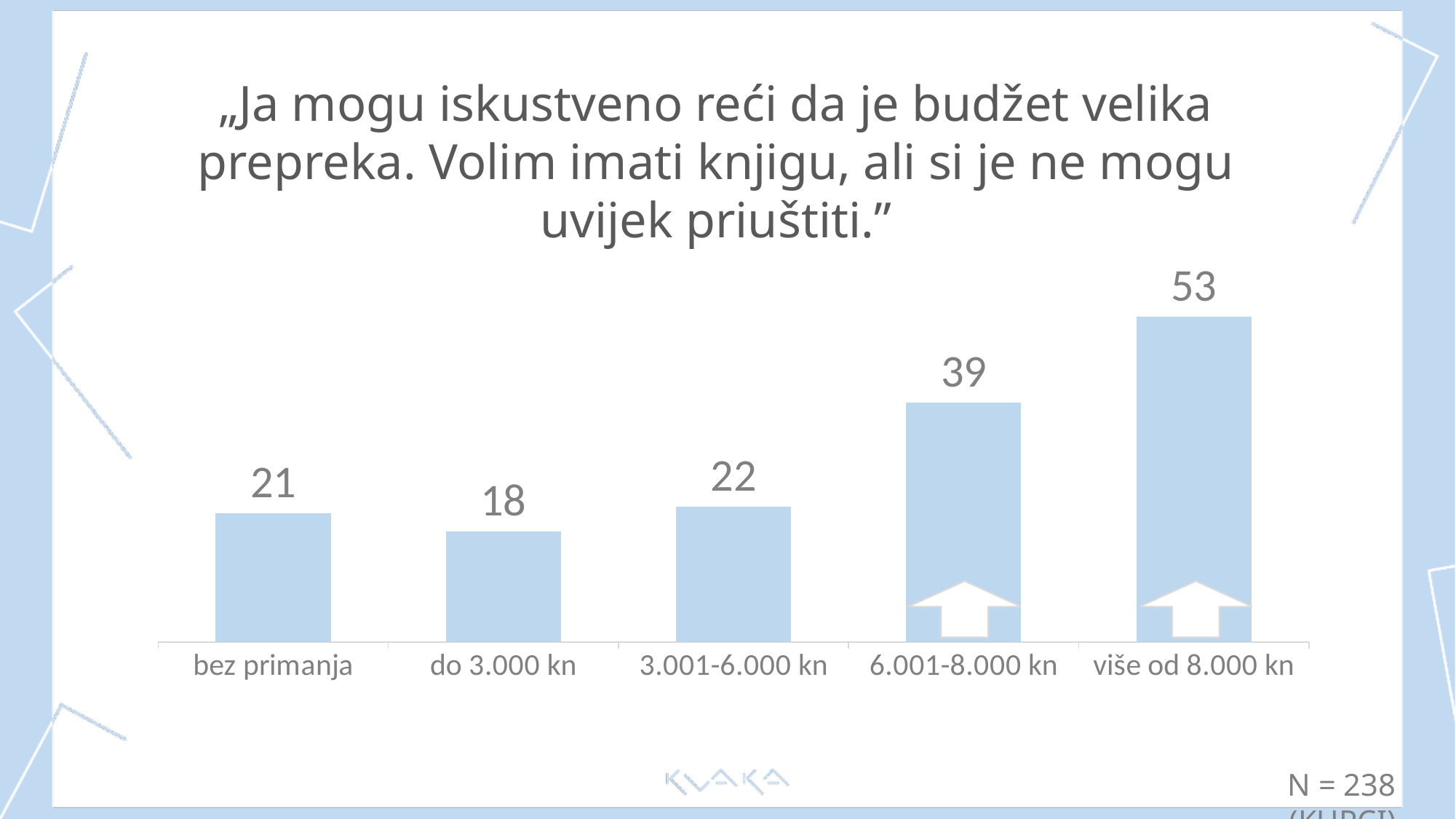
Which is larger, the value for 'bez primanja' or the value for '3.001-6.000 kn'? 3.001-6.000 kn What sample size (N) is stated on the slide? N = 238 Which category has the lowest value? do 3.000 kn What is the value for the 'bez primanja' category? 21 Which category has the highest value? više od 8.000 kn How many categories are shown on the chart? 5 What is the difference between the values for 'više od 8.000 kn' and '6.001-8.000 kn'? 14 What is the value for the 'do 3.000 kn' category? 18 What kind of chart is shown on the slide? bar chart What is the value for the '3.001-6.000 kn' category? 22 What is the value for the '6.001-8.000 kn' category? 39 What is the value for the 'više od 8.000 kn' category? 53